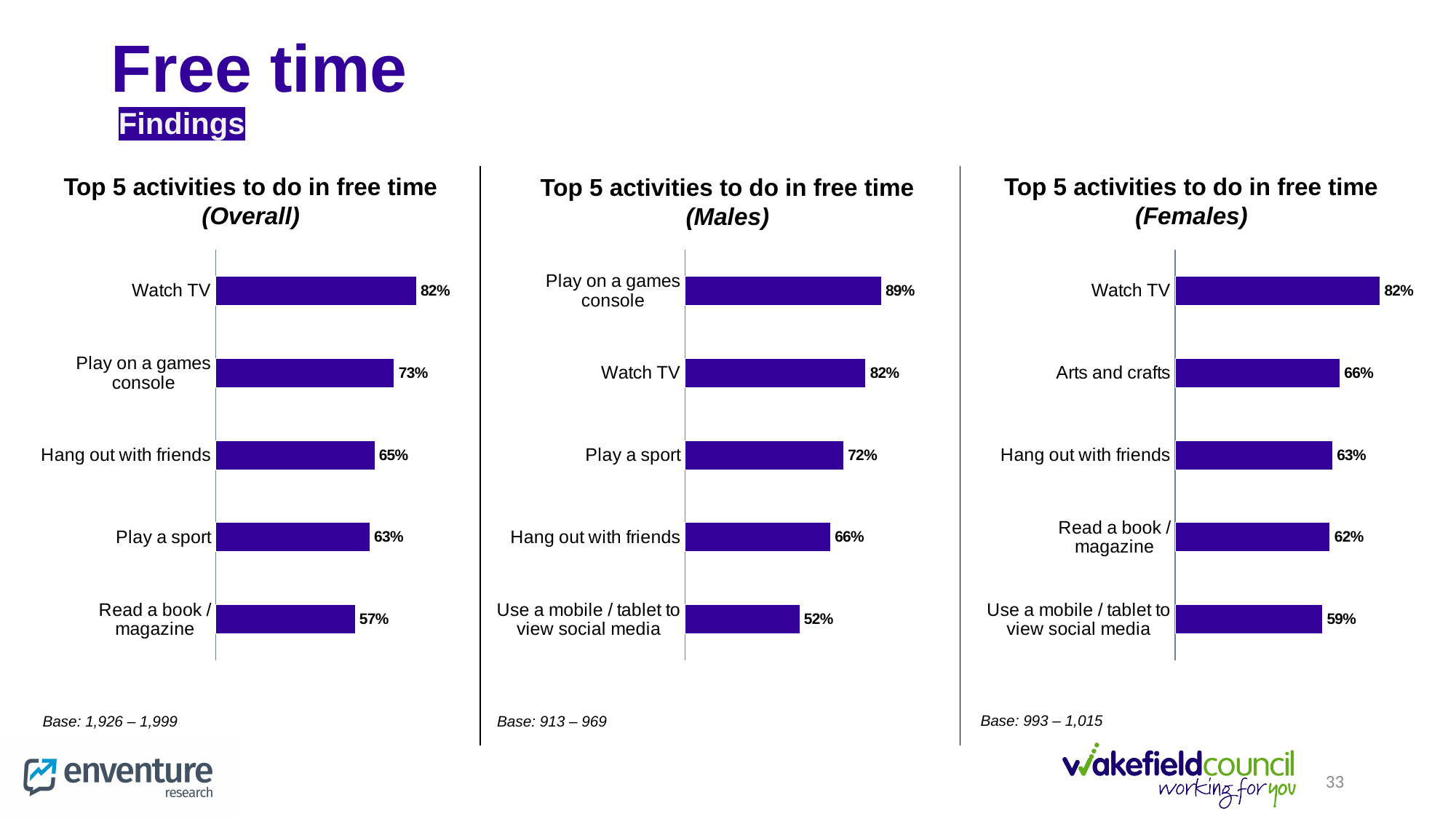
In the 'Top 5 activities to do in free time (Males)' chart, which activity has the highest value? Play on a games console In the 'Top 5 activities to do in free time (Females)' chart, what is the value for Arts and crafts? 66% In the 'Top 5 activities to do in free time (Overall)' chart, what is the difference between Watch TV and Read a book / magazine? 25% In the 'Top 5 activities to do in free time (Overall)' chart, which is larger: Hang out with friends or Play a sport? Hang out with friends In the 'Top 5 activities to do in free time (Overall)' chart, what is the value for Play on a games console? 73% In the 'Top 5 activities to do in free time (Males)' chart, what is the difference between Play on a games console and Use a mobile / tablet to view social media? 37% In the 'Top 5 activities to do in free time (Females)' chart, which activity has the lowest value? Use a mobile / tablet to view social media How many activities are shown in the 'Top 5 activities to do in free time (Females)' chart? 5 What base is shown beneath the 'Top 5 activities to do in free time (Males)' chart? 913 – 969 What kind of chart is the 'Top 5 activities to do in free time (Males)' chart? Bar chart In the 'Top 5 activities to do in free time (Overall)' chart, what is the value for Watch TV? 82% In the 'Top 5 activities to do in free time (Males)' chart, what is the value for Play a sport? 72%